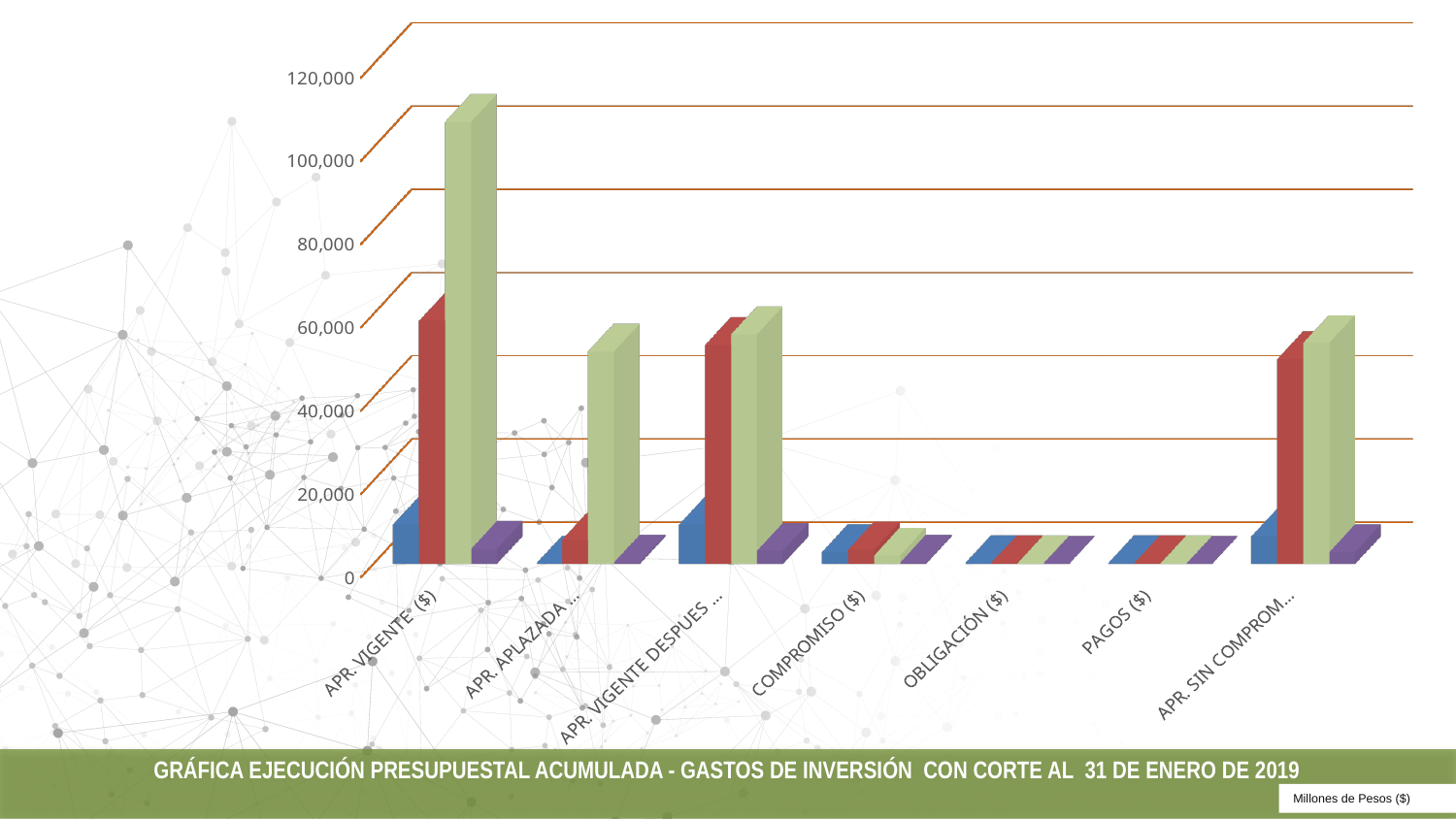
How many categories are shown along the x axis of the chart? 7 Which category has the tallest bar in the chart? APR. VIGENTE ($) Is the value of the green bar for APR. SIN COMPROM greater or less than 40,000? greater Is the value of the green bar for APR. APLAZADA greater or less than 40,000? greater Which has the larger green bar, APR. VIGENTE DESPUES or COMPROMISO ($)? APR. VIGENTE DESPUES How many bars are plotted for each category in the chart? 4 Is the value of the tallest (green) bar for APR. VIGENTE ($) greater or less than 100,000? greater Which has the larger green bar, APR. VIGENTE ($) or APR. APLAZADA? APR. VIGENTE ($) What unit is stated for the values in the chart? Millones de Pesos ($) What kind of chart is shown on the slide? bar chart